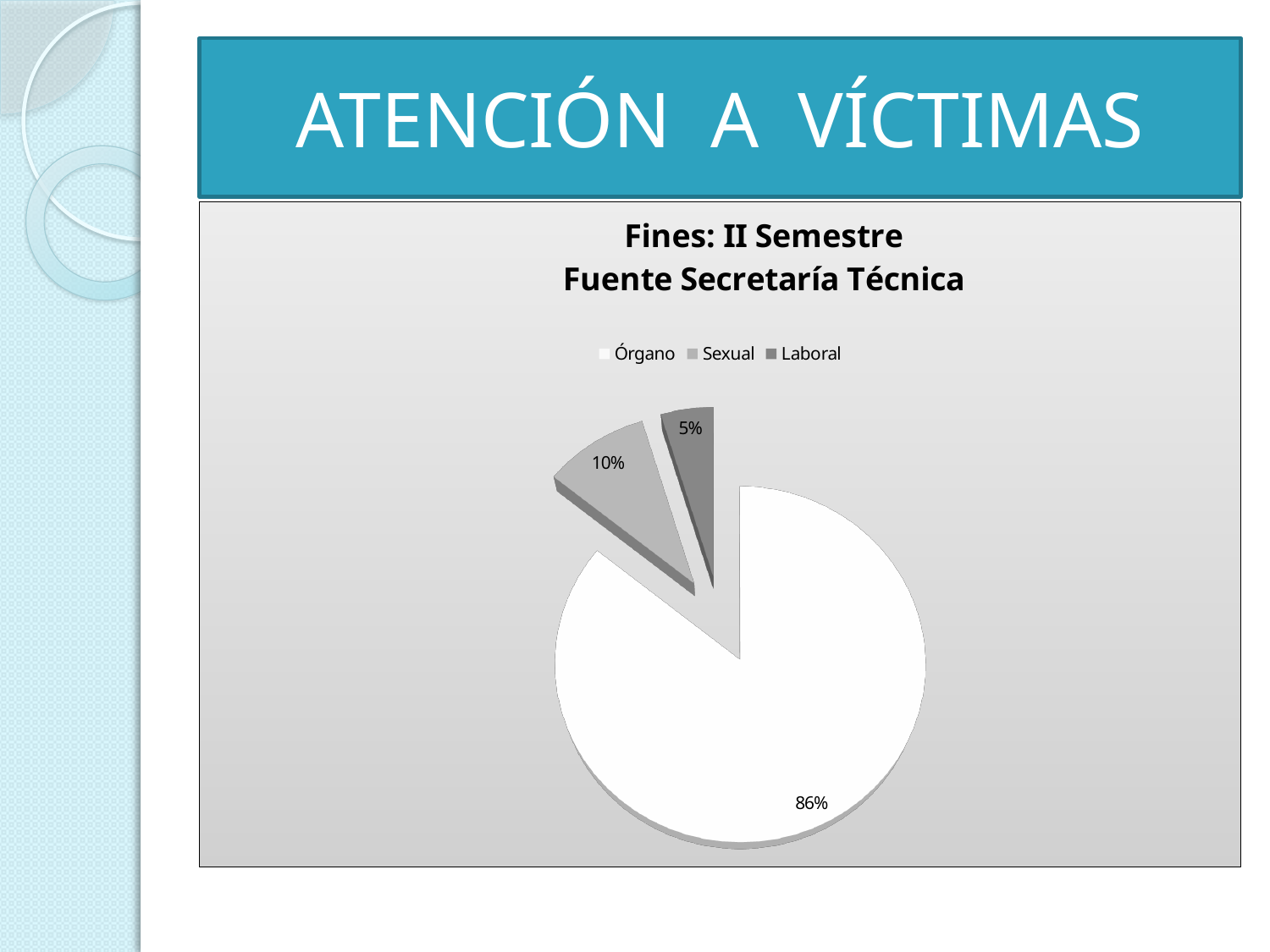
Which legend entry is shown in the darkest gray colour? Laboral How many categories does the legend of the pie chart list? 3 What is the difference in percentage points between the Órgano share and the Sexual share? 76 What kind of chart is shown on the slide? pie chart What share of the pie does Órgano represent? 86% Which category has the largest slice of the pie? Órgano What is the title of the chart? Fines: II Semestre Fuente Secretaría Técnica Which is larger, the share for Sexual or the share for Laboral? Sexual What share of the pie does Laboral represent? 5% Which category has the smallest slice of the pie? Laboral What is the difference in percentage points between the Sexual share and the Laboral share? 5 What share of the pie does Sexual represent? 10%